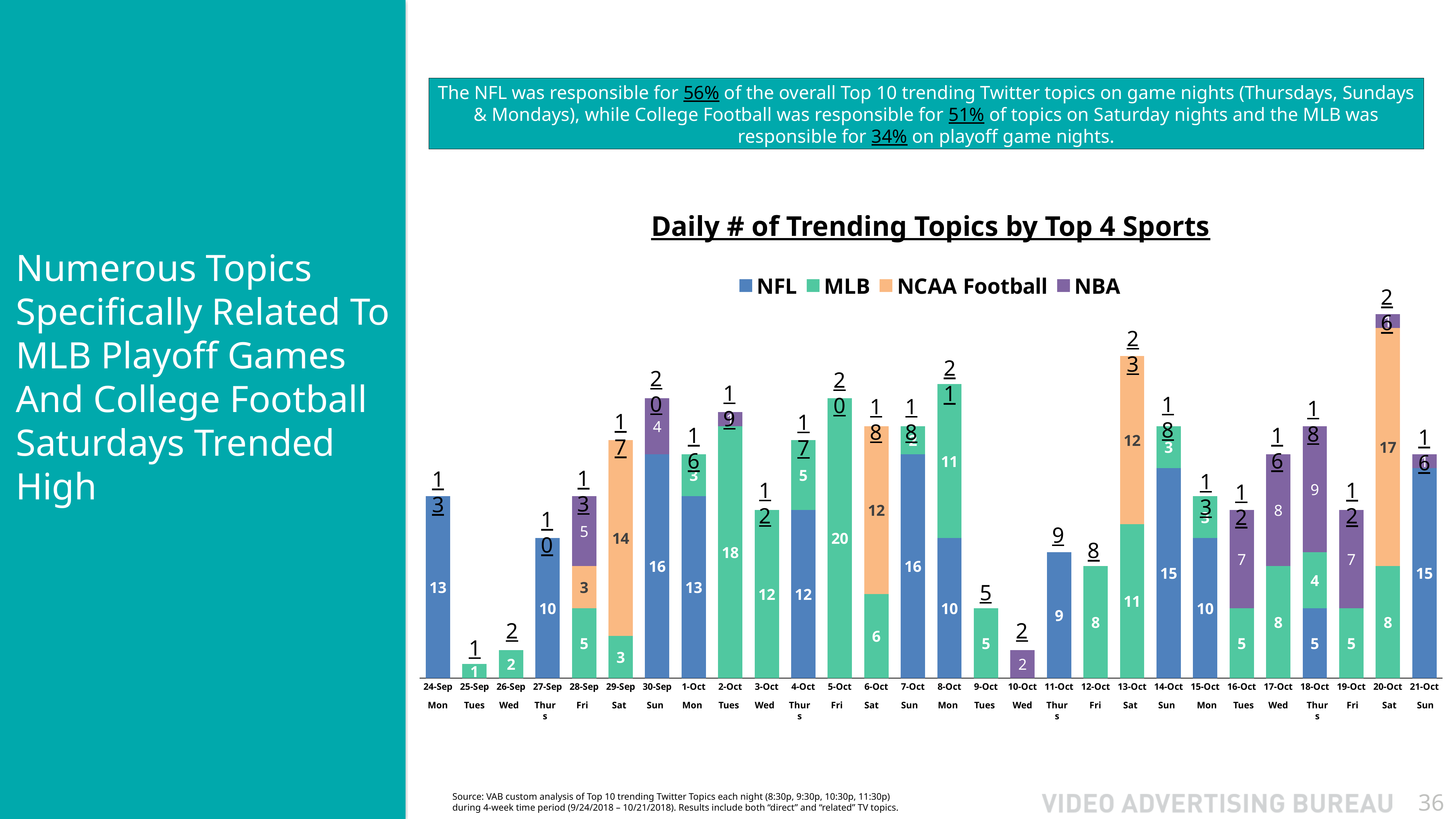
What is the title of the chart? Daily # of Trending Topics by Top 4 Sports How many dates (categories) are shown on the x axis of the chart? 28 Which is larger, the NBA value on 18-Oct or the NBA value on 16-Oct? 18-Oct What is the total of the stacked bar for 13-Oct? 23 What is the NCAA Football value on 29-Sep? 14 Which date has the highest total number of trending topics? 20-Oct What is the MLB value on 5-Oct? 20 What is the NFL value on 7-Oct? 16 What is the difference between the NCAA Football value on 20-Oct and the NCAA Football value on 6-Oct? 5 Which date has the lowest total number of trending topics? 25-Sep How many series does the legend of the chart list? 4 What kind of chart is shown on the slide? stacked bar chart